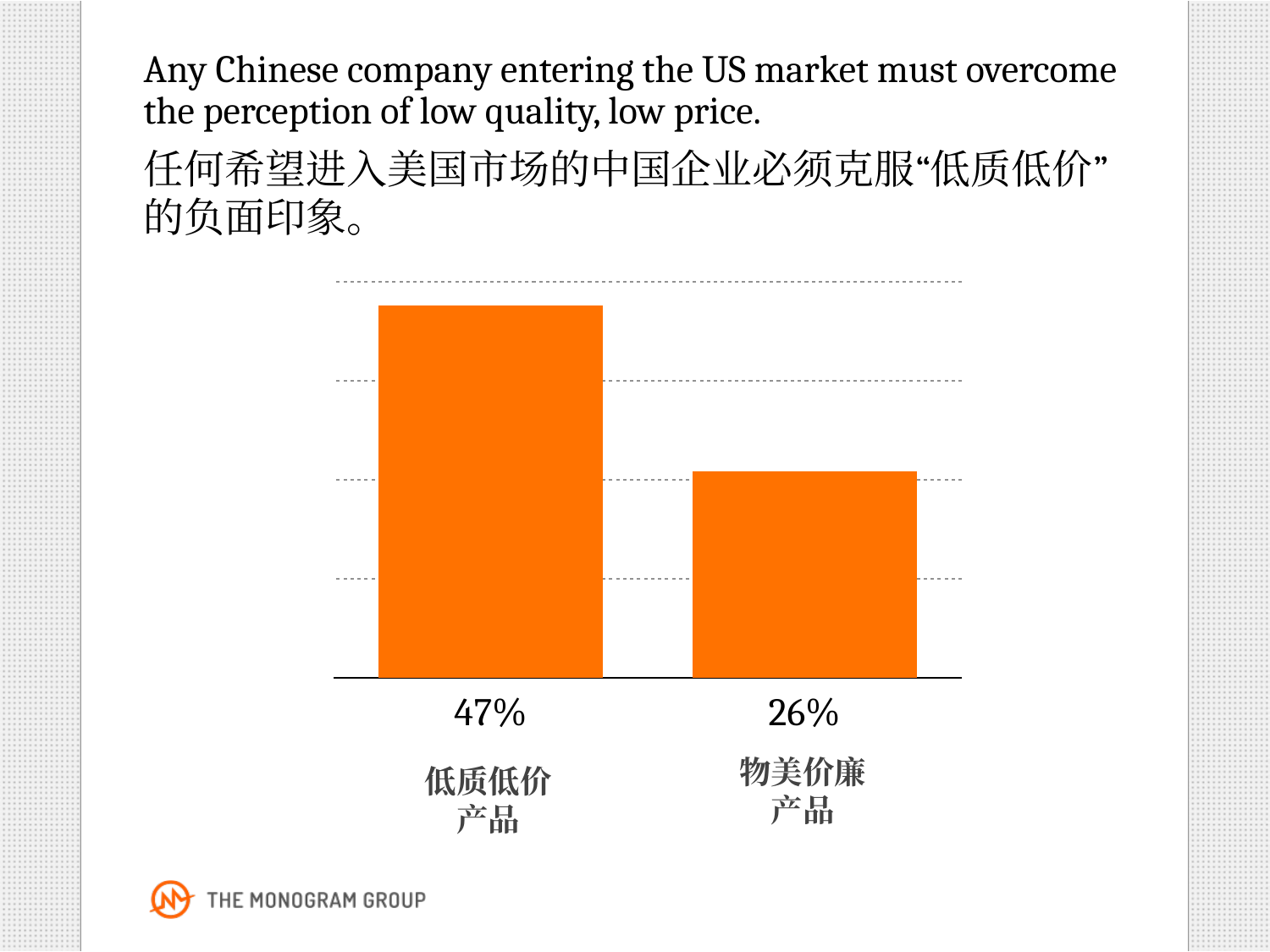
What colour are the bars in the chart? orange What is the total of the two values shown in the chart? 73% Is the value for 低质低价产品 larger or smaller than the value for 物美价廉产品? larger Which category has the lower value? 物美价廉产品 What value is shown for 低质低价产品? 47% Which category has the higher value? 低质低价产品 How many bars are shown in the chart? 2 What kind of chart is shown on the slide? bar chart What value is shown for 物美价廉产品? 26% What is the difference between the values for 低质低价产品 and 物美价廉产品? 21%